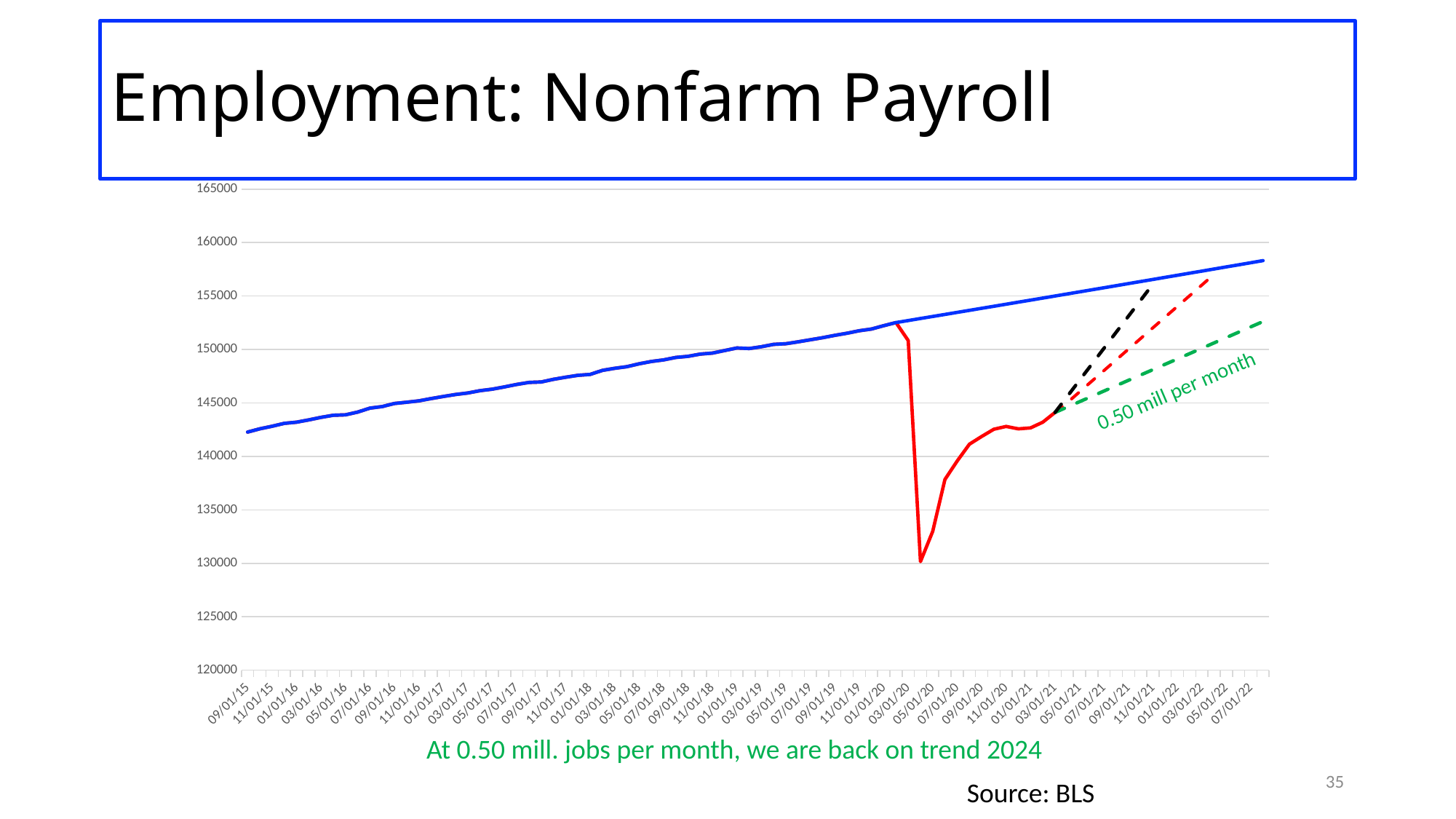
What is the highest value shown on the vertical axis? 165000 Is the value of the red line at 03/01/21 greater or less than 145000? less Is the lowest point of the red line (around 04/01/20) greater or less than 135000? less What is the title of the slide containing the chart? Employment: Nonfarm Payroll Is the value of the blue line at 01/01/20 greater or less than 150000? greater Does the blue trend line rise or fall from 09/01/15 to 07/01/22? rises Which is larger: the blue line value at 01/01/20 or the red line value at 03/01/21? the blue line value at 01/01/20 Does the red line rise or fall between 01/01/20 and 04/01/20? falls What kind of chart is shown on the slide? line chart What is the source cited for the chart? BLS